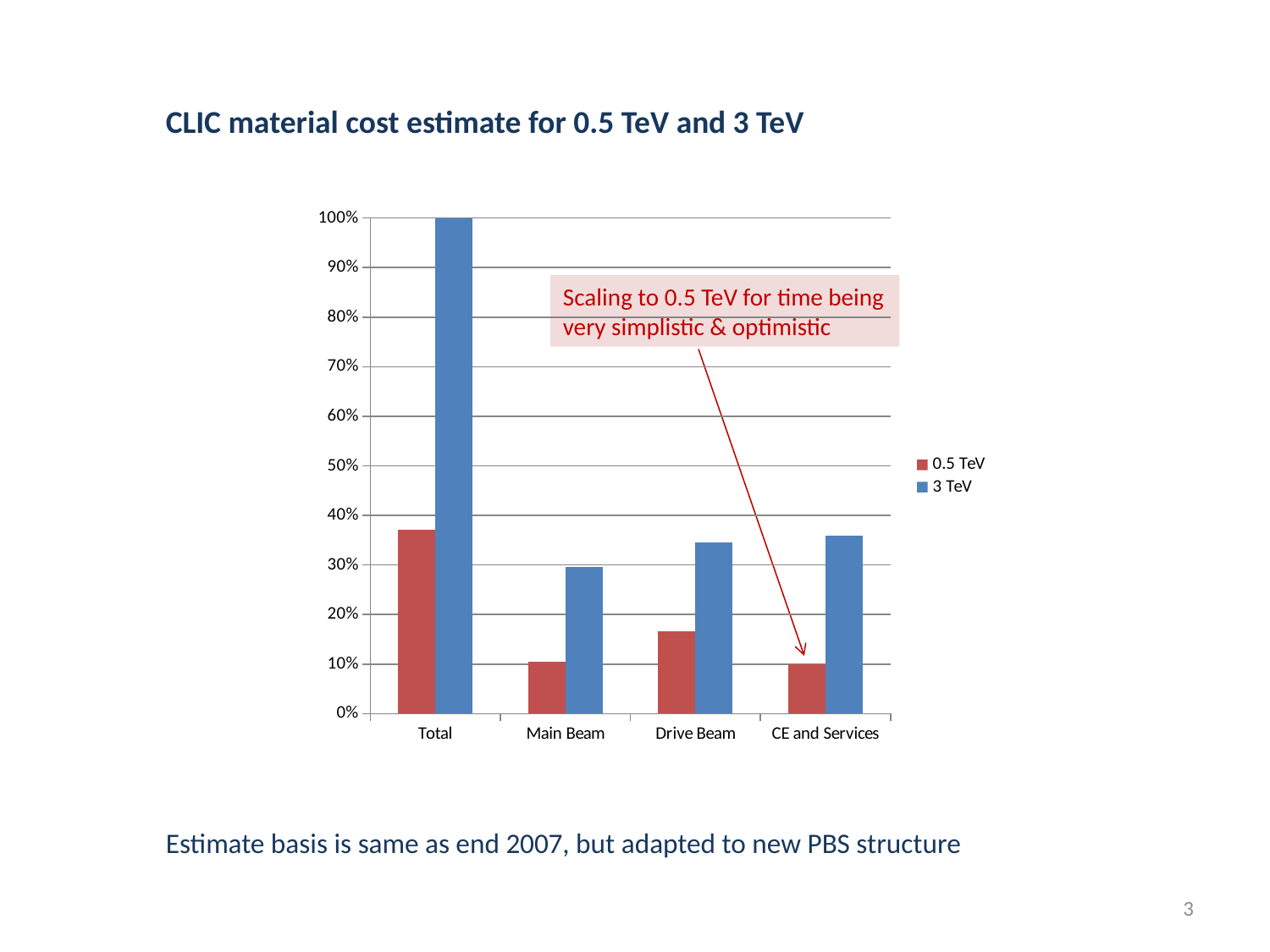
How many categories are shown on the x axis of the chart? 4 How many series does the chart's legend list? 2 Which is larger, the 0.5 TeV value for Drive Beam or the 0.5 TeV value for Main Beam? Drive Beam What colour are the 3 TeV bars in the chart? blue What kind of chart is shown on the slide? bar chart Which category has the highest 3 TeV bar? Total Which category has the lowest 3 TeV bar? Main Beam Is the 3 TeV value for CE and Services greater or less than 30%? greater Is the 0.5 TeV value for Total greater or less than 30%? greater Is the 0.5 TeV value for Drive Beam greater or less than 20%? less What is the value of the 3 TeV bar for Total? 100%